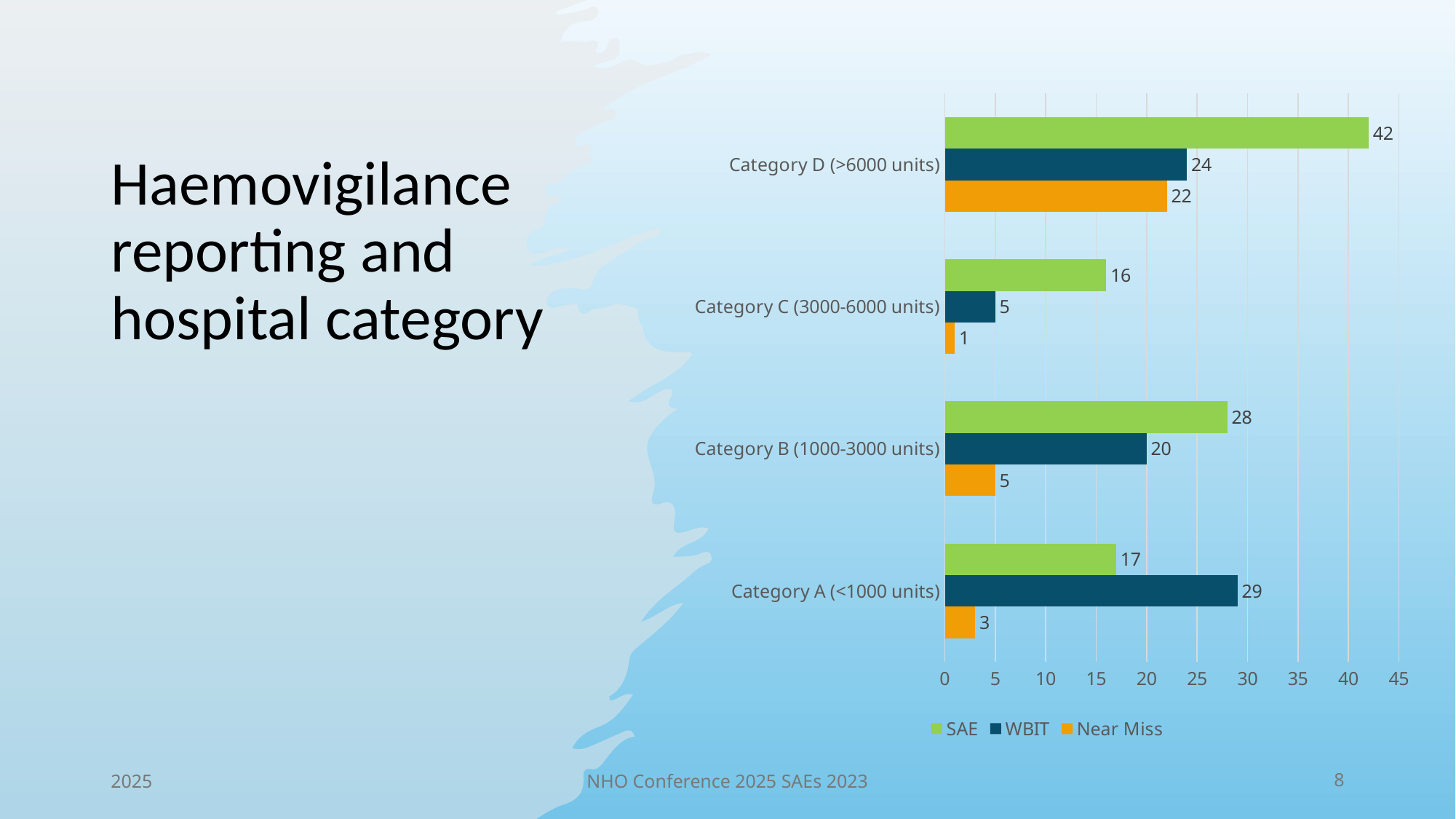
Which hospital category has the highest SAE value? Category D (>6000 units) What is the difference between the SAE and WBIT values for Category B (1000-3000 units)? 8 What is the WBIT value for Category A (<1000 units)? 29 Which hospital category has the lowest WBIT value? Category C (3000-6000 units) Which colour represents the Near Miss series in the chart? Orange What is the Near Miss value for Category C (3000-6000 units)? 1 For Category A (<1000 units), which is larger, the SAE value or the WBIT value? WBIT What kind of chart is shown on the slide? Bar chart How many series does the legend list? 3 What is the SAE value for Category D (>6000 units)? 42 Is the SAE value for Category D (>6000 units) greater or less than 40? greater How many hospital categories are shown on the chart? 4